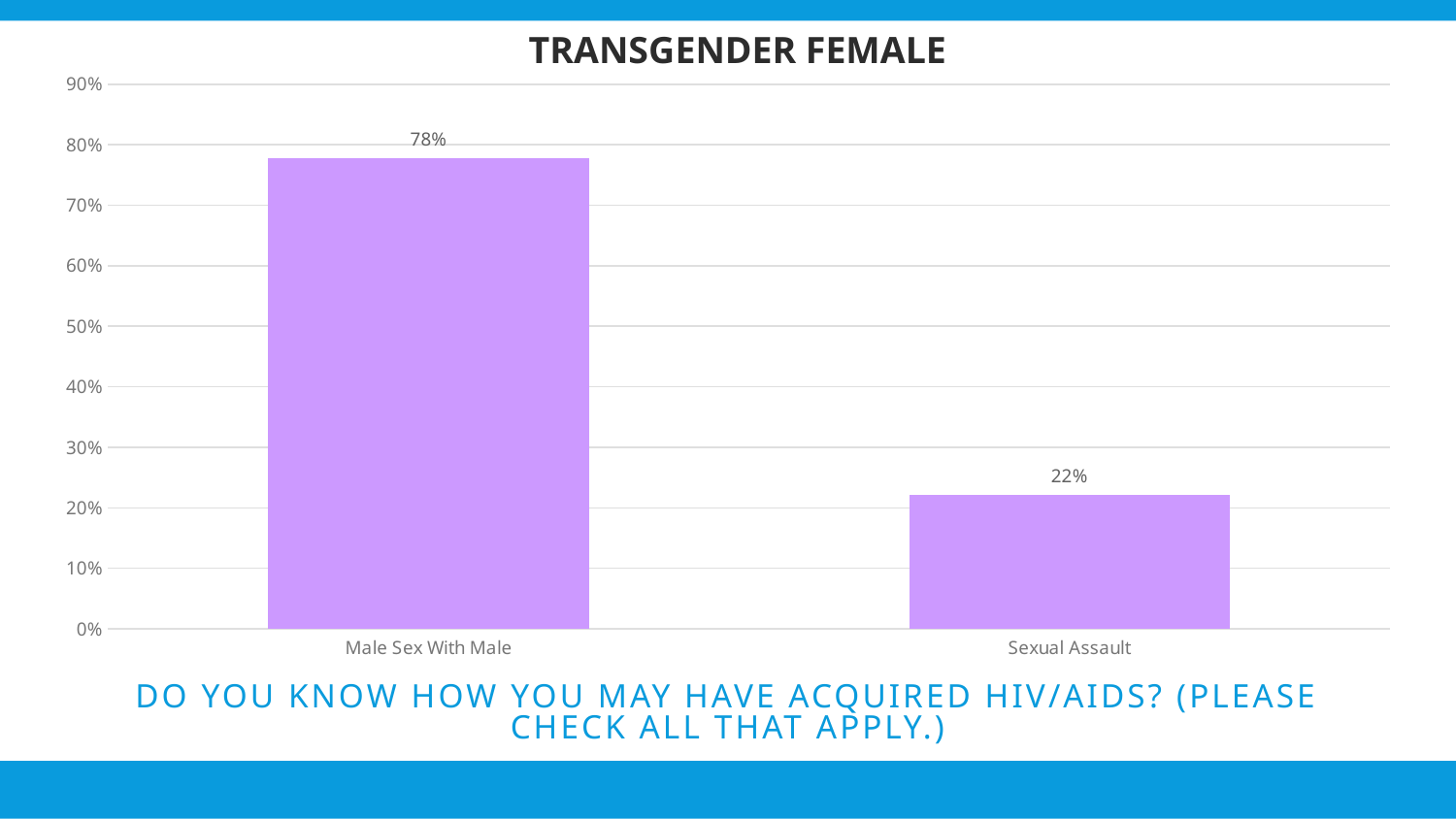
How many categories are shown in the chart? 2 Is the value for Sexual Assault greater or less than 30%? less What is the value for Sexual Assault? 22% What is the value for Male Sex With Male? 78% Is the value for Male Sex With Male greater or less than 70%? greater What is the difference between the values for Male Sex With Male and Sexual Assault? 56% What is the title of the chart? TRANSGENDER FEMALE Which category has the lowest value? Sexual Assault Which category has the highest value? Male Sex With Male Which is larger, the value for Male Sex With Male or the value for Sexual Assault? Male Sex With Male What kind of chart is shown on the slide? Bar chart What is the highest value shown on the vertical axis? 90%